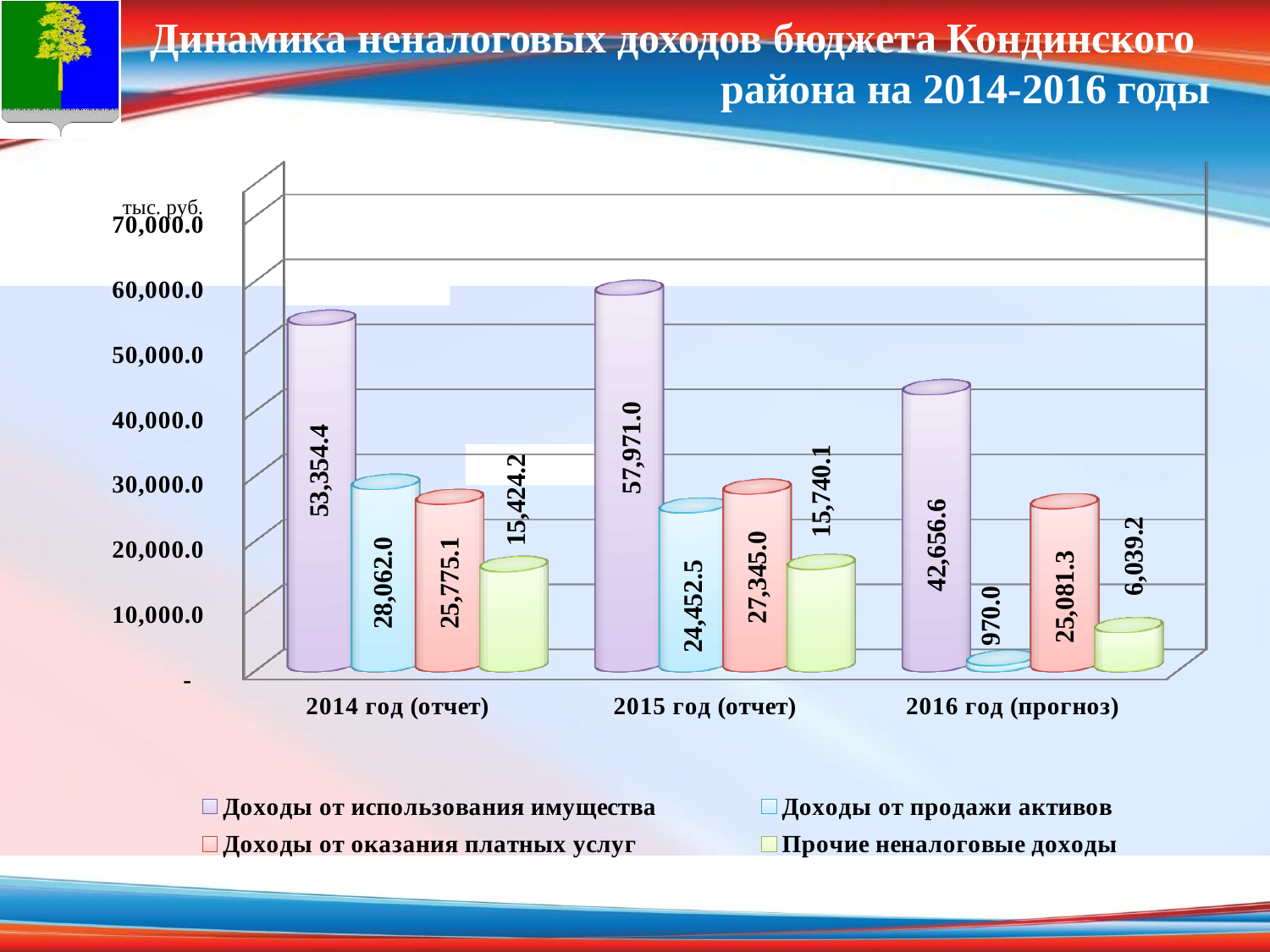
How many year categories are shown on the x axis? 3 What is the value for Прочие неналоговые доходы in 2015 год (отчет)? 15,740.1 Which is larger: Доходы от продажи активов in 2014 год (отчет) or Доходы от оказания платных услуг in 2014 год (отчет)? Доходы от продажи активов What kind of chart is shown on the slide? Bar chart What is the value for Доходы от продажи активов in 2016 год (прогноз)? 970.0 What is the value for Доходы от использования имущества in 2014 год (отчет)? 53,354.4 What unit is indicated on the vertical axis of the chart? тыс. руб. In which year is the value for Доходы от использования имущества highest? 2015 год (отчет) What is the value for Доходы от оказания платных услуг in 2016 год (прогноз)? 25,081.3 What is the difference between Доходы от использования имущества in 2015 год (отчет) and in 2016 год (прогноз)? 15,314.4 How many series does the legend list? 4 In which year is the value for Прочие неналоговые доходы lowest? 2016 год (прогноз)